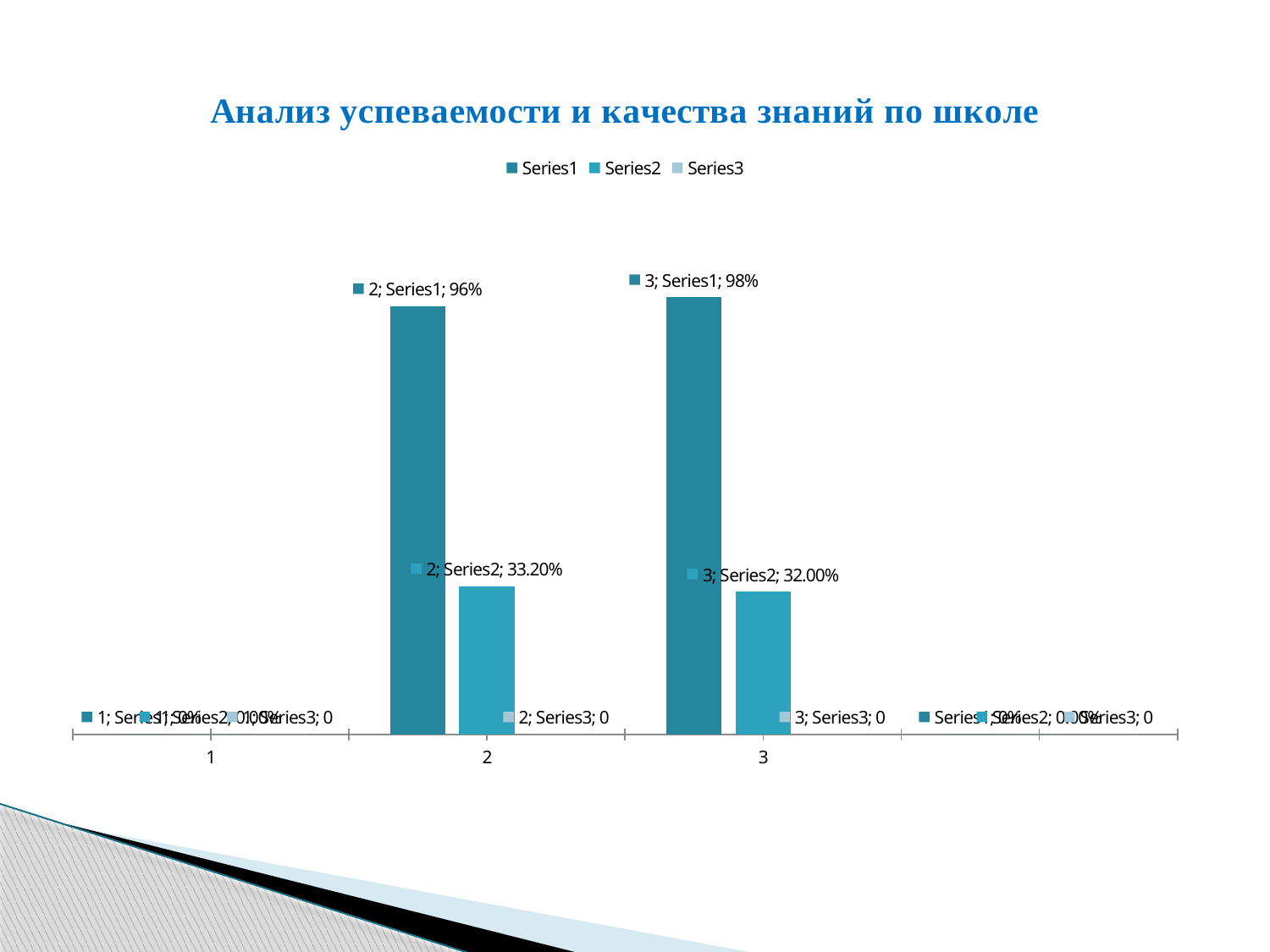
Which category has the higher Series1 value, 2 or 3? 3 What kind of chart is shown on the slide? Bar chart What is the value of Series3 for category 2? 0 What is the difference between the Series2 values for category 2 and category 3? 1.20% What is the difference between the Series1 values for category 3 and category 2? 2% What is the value of Series1 for category 2? 96% What is the title of the chart? Анализ успеваемости и качества знаний по школе What is the value of Series1 for category 3? 98% Which category has the higher Series2 value, 2 or 3? 2 What is the value of Series2 for category 2? 33.20% How many series does the legend list? 3 What is the value of Series2 for category 3? 32.00%